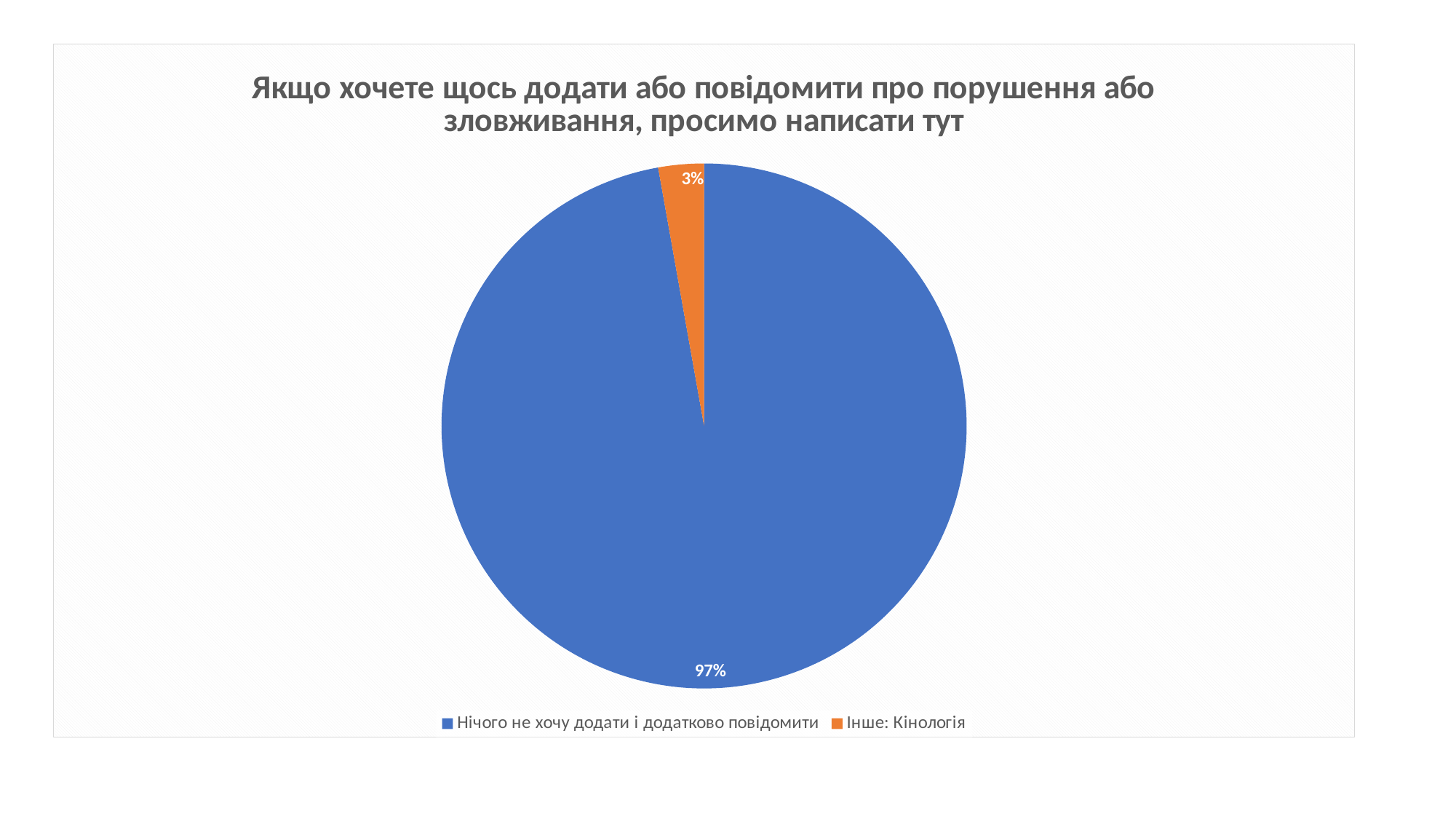
Which category has the smallest slice of the pie? Інше: Кінологія What colour is the slice for "Інше: Кінологія"? orange Which is larger: the slice for "Інше: Кінологія" or the slice for "Нічого не хочу додати і додатково повідомити"? Нічого не хочу додати і додатково повідомити What is the title of the chart? Якщо хочете щось додати або повідомити про порушення або зловживання, просимо написати тут What share of the pie does "Інше: Кінологія" take? 3% What share of the pie does "Нічого не хочу додати і додатково повідомити" take? 97% How many entries does the legend list? 2 How many categories does the pie chart have? 2 Which category has the largest slice of the pie? Нічого не хочу додати і додатково повідомити What kind of chart is shown on the slide? pie chart What is the difference in percentage points between the "Нічого не хочу додати і додатково повідомити" slice and the "Інше: Кінологія" slice? 94